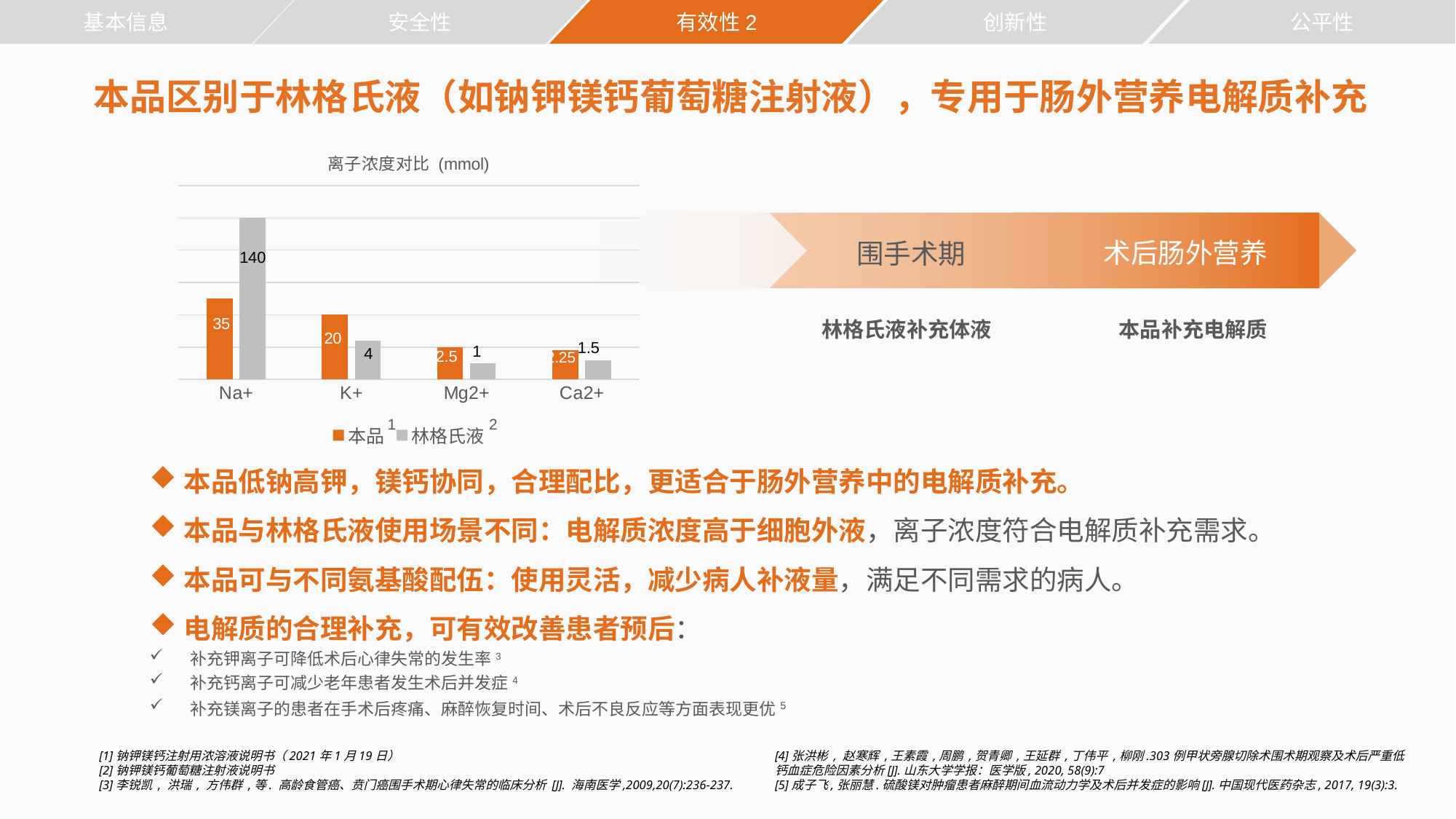
In the 离子浓度对比（mmol） chart, which series has the larger value at K+, 本品 or 林格氏液? 本品 How many ion categories are shown on the x axis of the 离子浓度对比（mmol） chart? 4 In the 离子浓度对比（mmol） chart, what is the value for 林格氏液 at Ca2+? 1.5 In the 离子浓度对比（mmol） chart, what is the value for 本品 at K+? 20 What kind of chart is the 离子浓度对比（mmol） chart? bar chart In the 离子浓度对比（mmol） chart, what is the difference between 林格氏液 and 本品 at Na+? 105 In the 离子浓度对比（mmol） chart, what is the value for 本品 at Na+? 35 How many series does the legend of the 离子浓度对比（mmol） chart list? 2 In the 离子浓度对比（mmol） chart, what is the value for 本品 at Mg2+? 2.5 In the 离子浓度对比（mmol） chart, what is the value for 林格氏液 at K+? 4 In the 离子浓度对比（mmol） chart, which ion has the highest value for 林格氏液? Na+ In the 离子浓度对比（mmol） chart, what is the value for 林格氏液 at Na+? 140